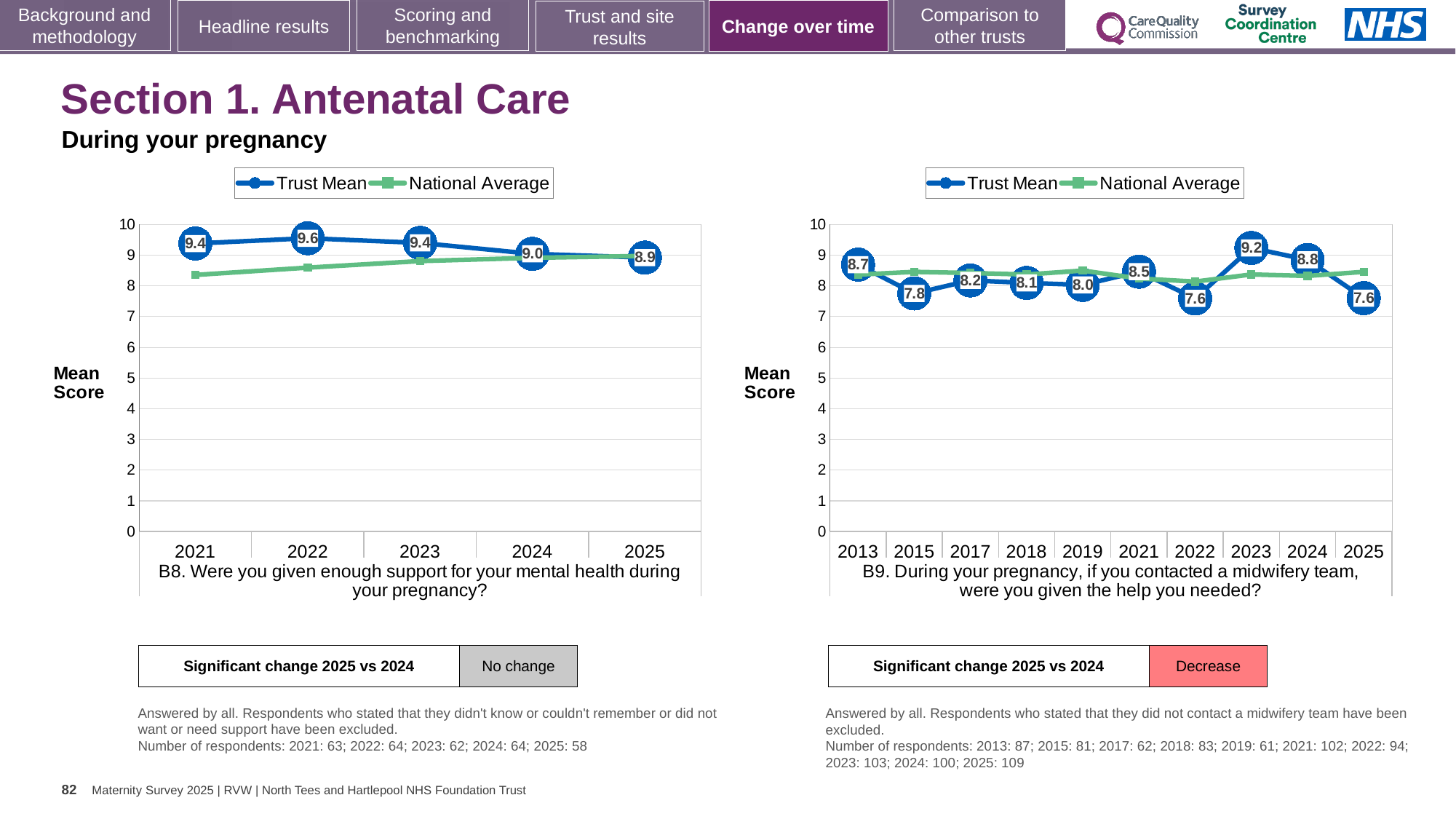
In the B8 chart (left), what is the difference between the Trust Mean in 2022 and in 2025? 0.7 In the B9 chart (right), is the Trust Mean higher in 2013 or in 2015? 2013 How many series does the legend of the B9 chart (right) list? 2 In the B8 chart (left), what is the Trust Mean for 2025? 8.9 In the B8 chart (left), which year has the highest Trust Mean? 2022 In the B8 chart (left), what is the Trust Mean for 2022? 9.6 In the B8 chart (left), how many years are shown on the x axis? 5 In the B8 chart (left), is the National Average for 2021 greater or less than 9? less In the B9 chart (right), what is the difference between the Trust Mean in 2024 and in 2025? 1.2 In the B9 chart (right), what is the Trust Mean for 2023? 9.2 In the B9 chart (right), which year has the highest Trust Mean? 2023 In the B9 chart (right), how many years are shown on the x axis? 10